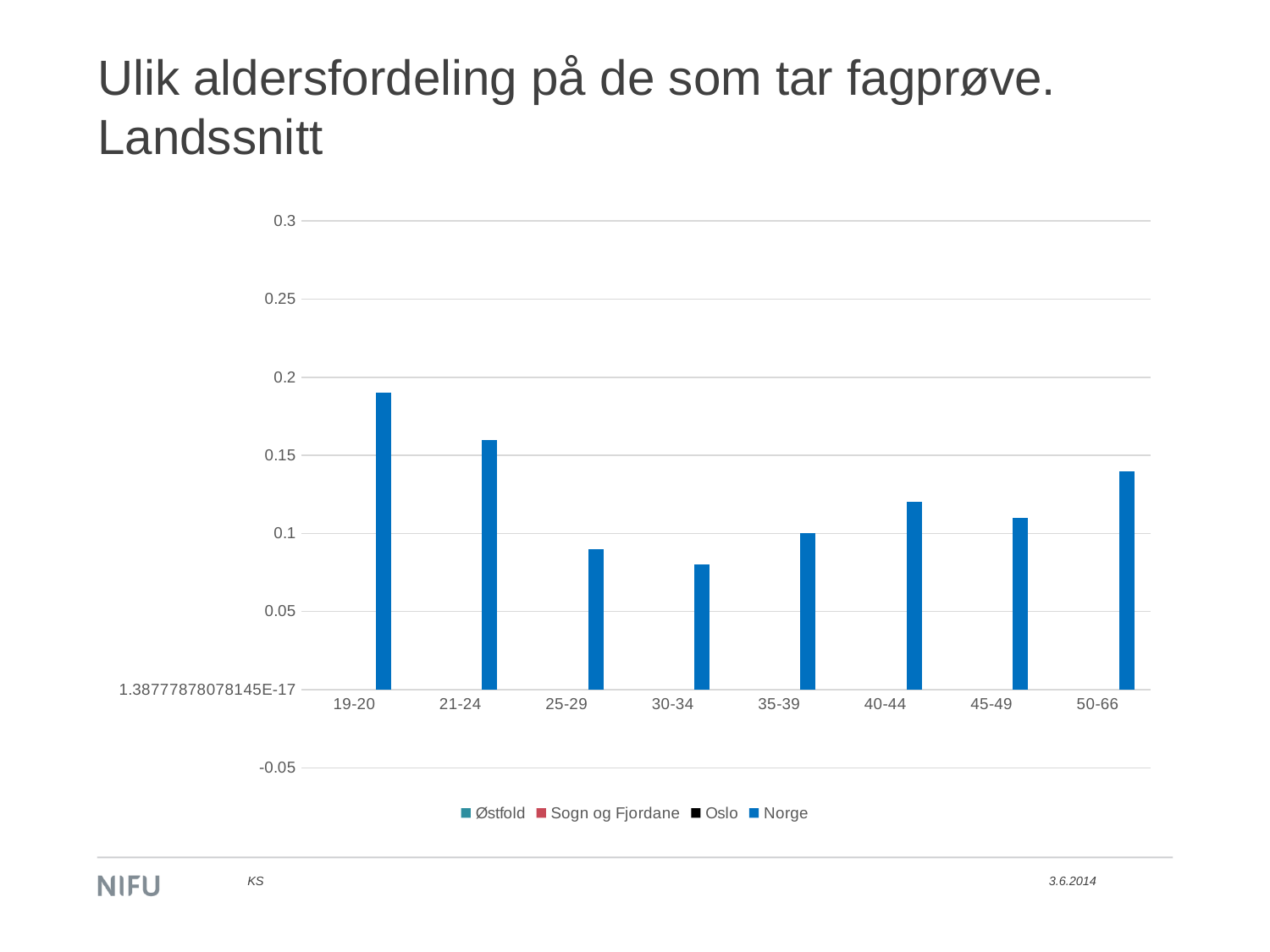
Is the value for 21-24 greater or less than 0.15? greater Which legend entry is shown in blue? Norge Which is larger, the value for 50-66 or the value for 25-29? 50-66 Which is larger, the value for 19-20 or the value for 21-24? 19-20 Is the value for 19-20 greater or less than 0.15? greater Do the values rise or fall from 19-20 to 30-34? fall Is the value for 30-34 greater or less than 0.1? less How many age-group categories are shown on the x axis? 8 How many series does the legend list? 4 Which age group has the highest bar? 19-20 What kind of chart is shown on the slide? bar chart